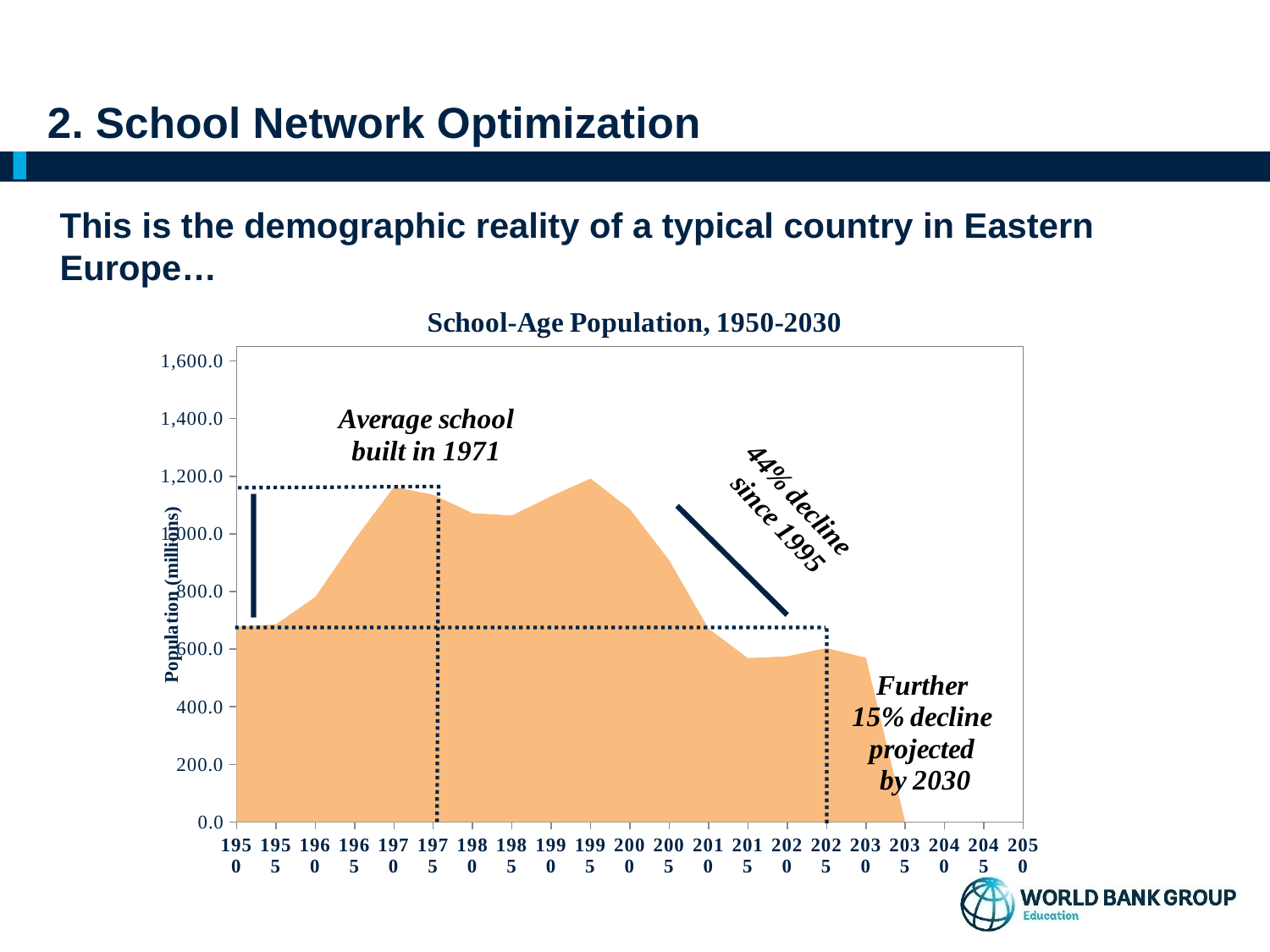
What kind of chart is shown on the slide? area chart What is the title of the chart? School-Age Population, 1950-2030 Is the school-age population value for 1950 greater or less than 800.0? less Is the school-age population value for 1995 greater or less than 1,000.0? greater Is the school-age population value for 1970 greater or less than 1,000.0? greater Does the school-age population rise or fall between 1950 and 1970? rise Which year has the larger school-age population, 1950 or 1970? 1970 Does the school-age population rise or fall between 1995 and 2015? fall Which year has the larger school-age population, 1995 or 2015? 1995 According to the annotation on the chart, what percentage decline has occurred since 1995? 44% decline